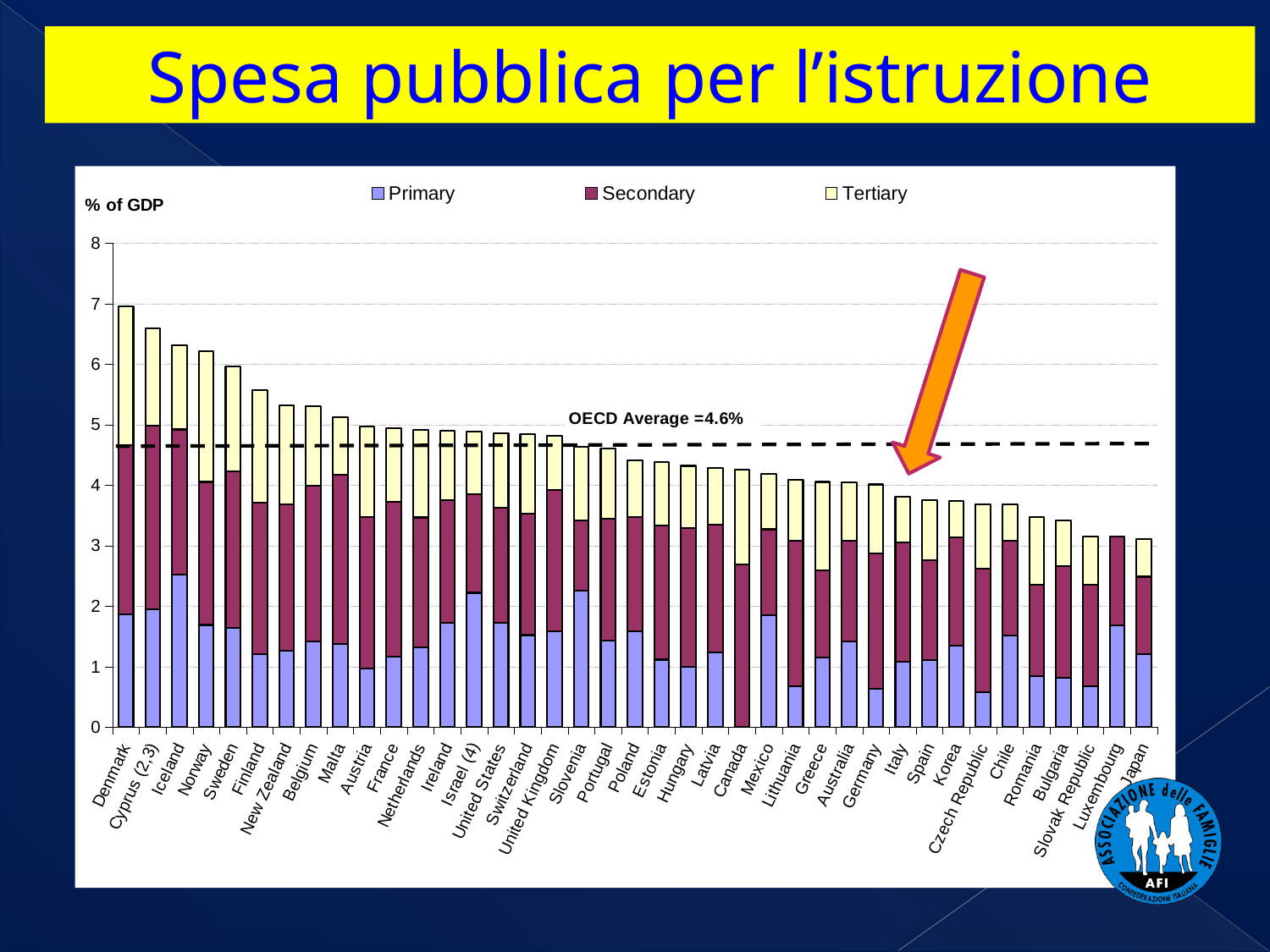
What unit label is shown at the top left of the chart's y axis? % of GDP What kind of chart is shown on the slide? Stacked bar chart Is the total value for Denmark greater or less than 6? greater Which series are listed in the legend? Primary, Secondary, Tertiary How many countries are shown on the x axis? 39 What is the OECD average value printed on the chart? 4.6% Which has a larger total, Denmark or Italy? Denmark Is the total value for Japan greater or less than 4? less How many series does the legend list? 3 Do the total values rise or fall moving from left to right along the x axis? Fall Which country has the highest total public spending on education as % of GDP? Denmark Is the total value for Italy greater or less than 4? less